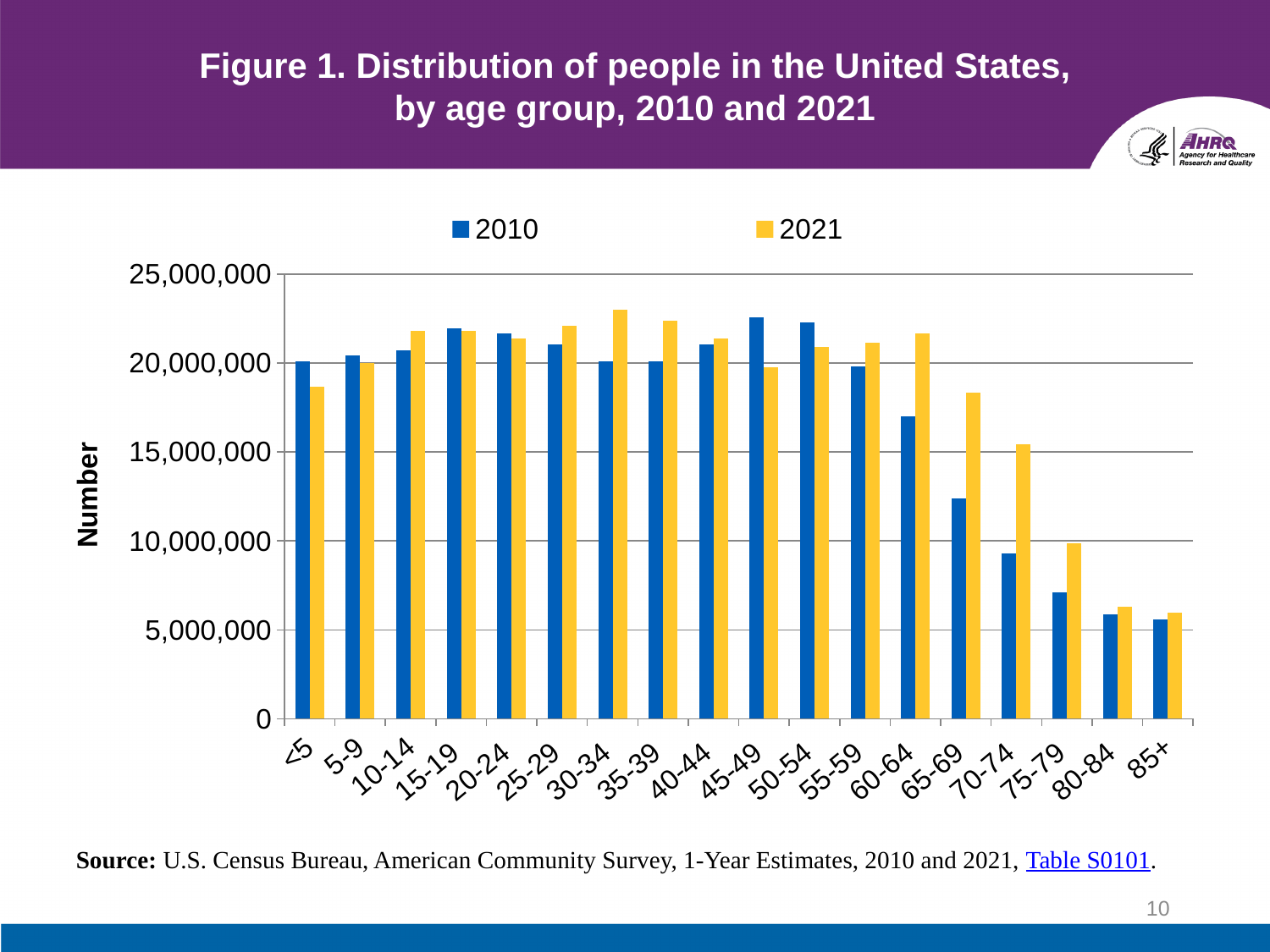
For the 45-49 age group, which year has the larger value, 2010 or 2021? 2010 Is the 2021 value for the <5 age group greater or less than 20,000,000? less How many series does the legend list? 2 Is the 2021 value for the 70-74 age group greater or less than 10,000,000? greater Do the 2021 values rise or fall across the age groups from 65-69 to 85+? fall Is the 2010 value for the 75-79 age group greater or less than 10,000,000? less For the 65-69 age group, which year has the larger value, 2010 or 2021? 2021 Which colour represents the 2021 series? yellow How many age groups are shown on the x axis? 18 What kind of chart is shown on the slide? bar chart Which age group has the highest value for 2021? 30-34